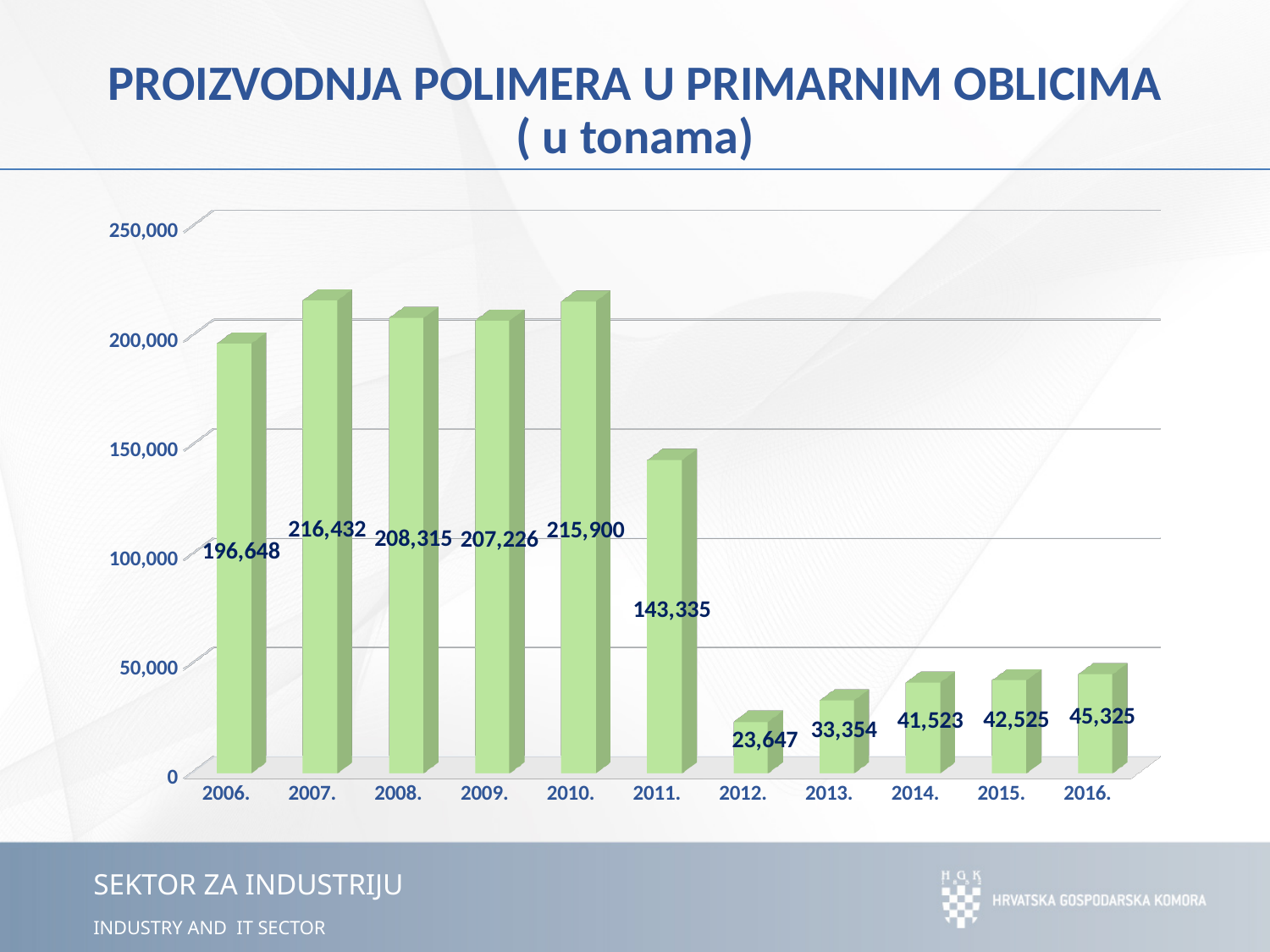
What is the value for 2006.? 196,648 What is the value for 2011.? 143,335 Which year has the lowest value? 2012. What is the value for 2016.? 45,325 What kind of chart is shown on the slide? bar chart Which year has the highest value? 2007. How many years are shown on the x axis? 11 What is the difference between the values for 2011. and 2012.? 119,688 Do the values rise or fall from 2012. to 2016.? rise Which is larger, the value for 2008. or the value for 2009.? 2008. What is the difference between the values for 2016. and 2015.? 2,800 Is the value for 2011. greater or less than 150,000? less